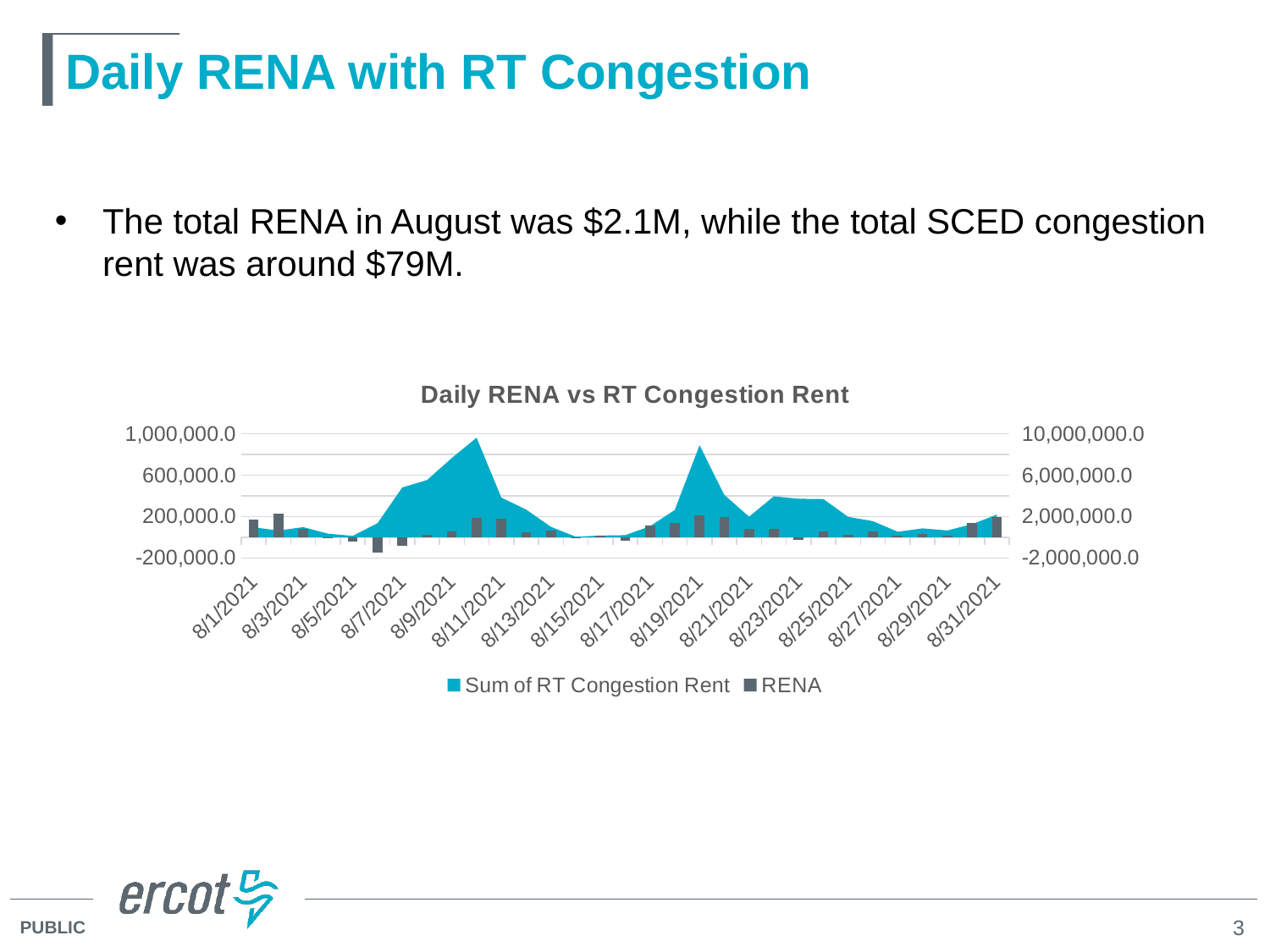
Does the Sum of RT Congestion Rent rise or fall from 8/15/2021 to 8/19/2021? rise What are the two series named in the chart legend? Sum of RT Congestion Rent and RENA Which series in the chart is drawn as bars? RENA How many date labels are shown along the x axis of the chart? 16 What is the highest tick value shown on the right vertical axis? 10,000,000.0 What is the lowest tick value shown on the right vertical axis? -2,000,000.0 Is the RENA bar for 8/19/2021 greater or less than 0? greater Is the Sum of RT Congestion Rent larger on 8/19/2021 or on 8/15/2021? 8/19/2021 How many series does the chart legend list? 2 What is the highest tick value shown on the left vertical axis? 1,000,000.0 Does the Sum of RT Congestion Rent rise or fall from 8/11/2021 to 8/15/2021? fall What is the title of the chart? Daily RENA vs RT Congestion Rent